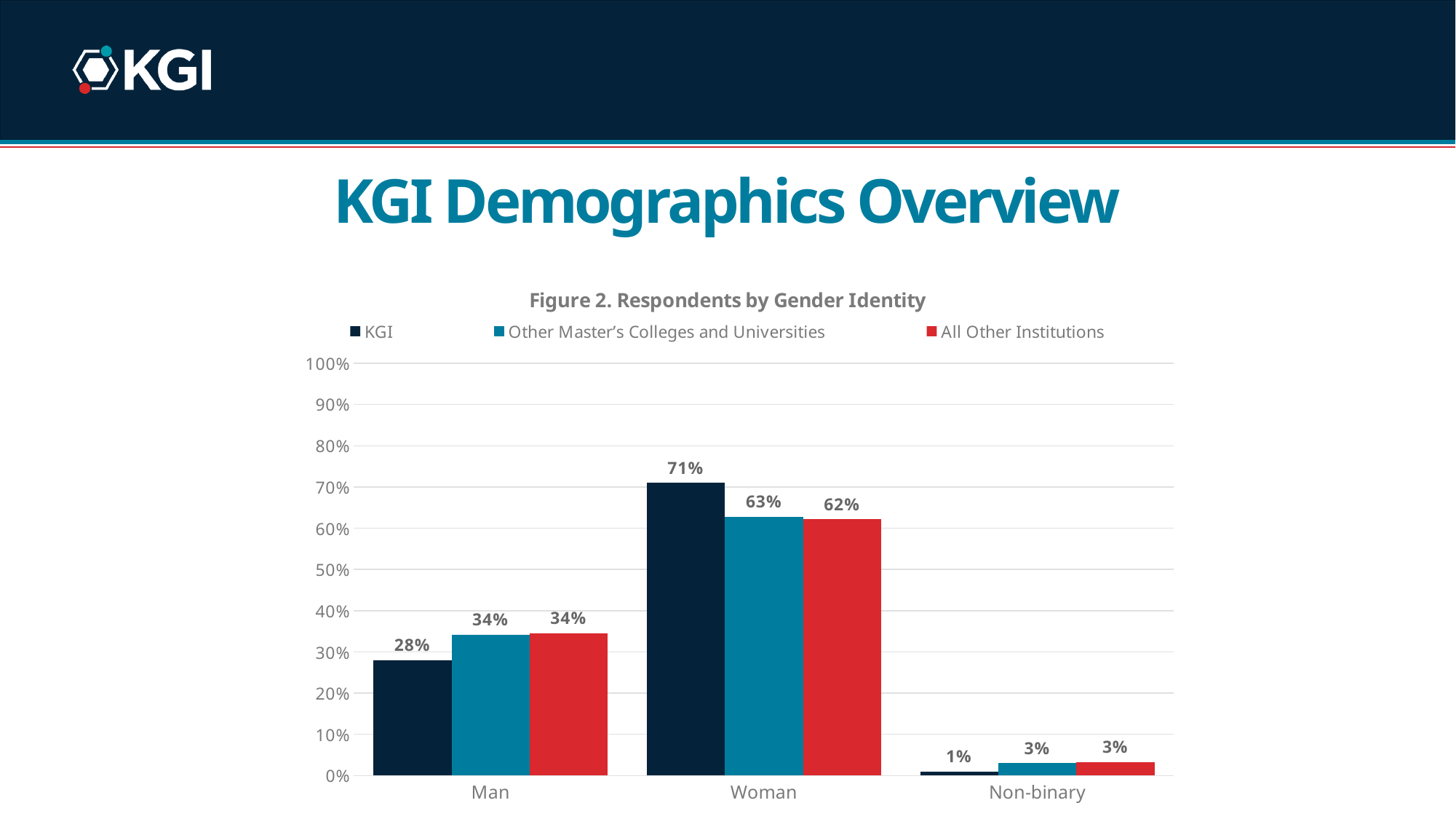
What is the title of the chart? Figure 2. Respondents by Gender Identity How many series does the legend list? 3 What is the value for Other Master's Colleges and Universities in the Man category? 34% Which gender identity category has the lowest value for All Other Institutions? Non-binary Which gender identity category has the highest value for KGI? Woman What is the value for All Other Institutions in the Non-binary category? 3% What kind of chart is shown on the slide? Bar chart How many gender identity categories are shown on the x axis? 3 Is the KGI value for Woman greater or less than 60%? greater What percentage of KGI respondents identify as Woman? 71% What is the difference between the KGI value and the All Other Institutions value in the Woman category? 9% In the Man category, which is larger: the KGI value or the Other Master's Colleges and Universities value? Other Master's Colleges and Universities